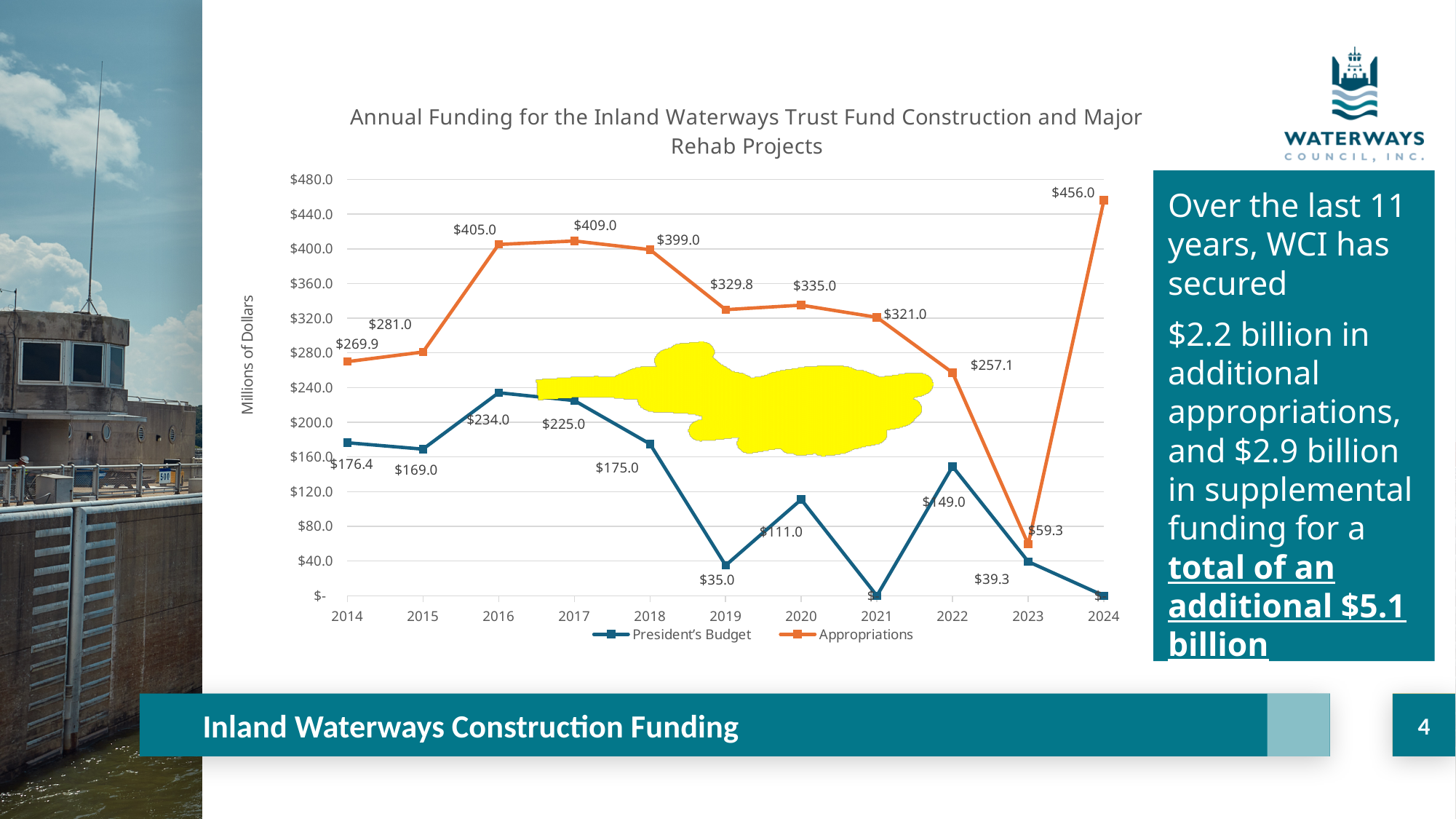
In 2019, which is larger: Appropriations or the President's Budget? Appropriations What is the Appropriations value for 2024? $456.0 How many series does the legend list? 2 In which year is the Appropriations value highest? 2024 How many years are shown on the x axis? 11 What is the difference between Appropriations and the President's Budget in 2017? $184.0 Is the President's Budget value for 2021 greater or less than $40.0? less What is the Appropriations value for 2019? $329.8 What is the President's Budget value for 2016? $234.0 In which year is the President's Budget value highest? 2016 In which year is the Appropriations value lowest? 2023 What kind of chart is shown on the slide? line chart